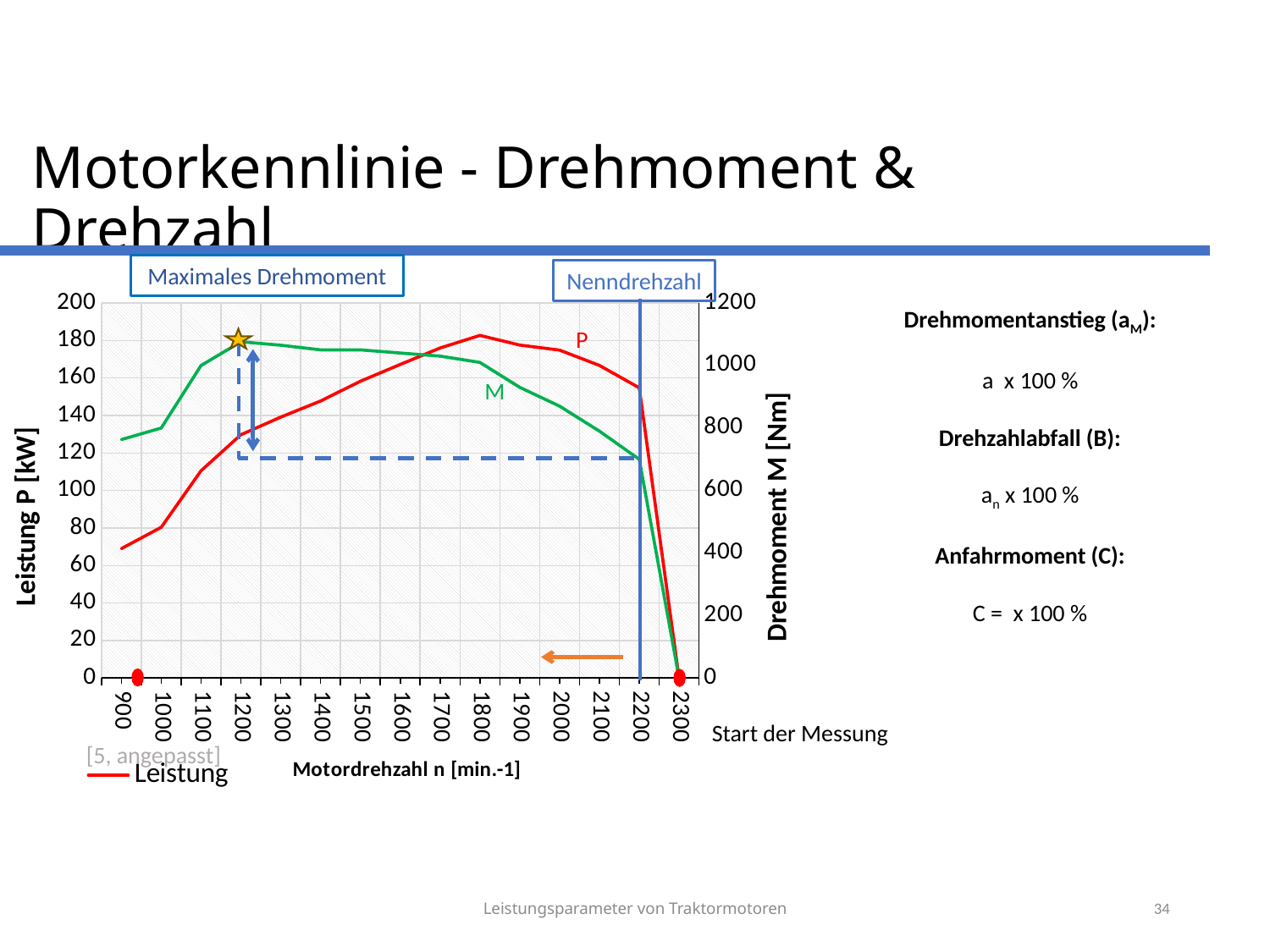
Is the Drehmoment value at 1200 min-1 greater or less than 1000 Nm? greater What kind of chart is shown on the slide? line chart Which is larger, the Drehmoment at 1100 min-1 or at 2100 min-1? 1100 min-1 Does the Leistung (P) curve rise or fall between 900 and 1800 min-1? rise How many tick labels are shown on the x axis? 15 How many lines are plotted on the chart? 2 At which engine speed does the Drehmoment (M) curve reach its highest value? 1200 Is the Leistung value at 900 min-1 greater or less than 80 kW? less At which engine speed does the Leistung (P) curve reach its highest value? 1800 What is the title of the x axis of the chart? Motordrehzahl n [min.-1] Is the Leistung value at 1800 min-1 greater or less than 160 kW? greater Which series does the chart legend list? Leistung